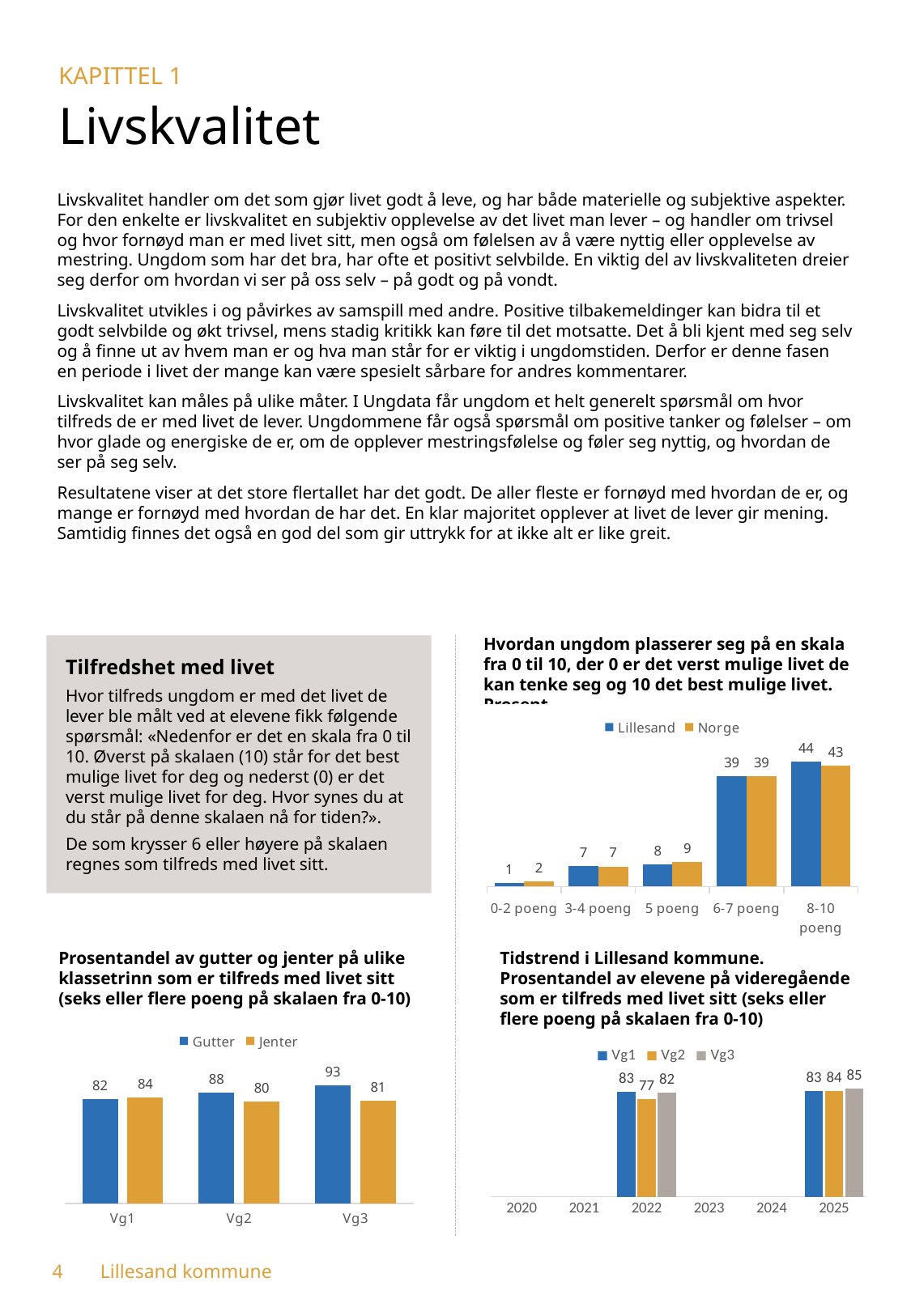
In the top-right chart (Hvordan ungdom plasserer seg på en skala fra 0 til 10), what is the value for Lillesand in the 8-10 poeng category? 44 In the top-right chart (Hvordan ungdom plasserer seg på en skala fra 0 til 10), which category has the lowest value for Lillesand? 0-2 poeng In the bottom-left chart (Prosentandel av gutter og jenter på ulike klassetrinn), do the Gutter values rise or fall from Vg1 to Vg3? rise In the bottom-right chart (Tidstrend i Lillesand kommune), what is the value for Vg2 in 2022? 77 In the top-right chart (Hvordan ungdom plasserer seg på en skala fra 0 til 10), how many categories are shown on the x axis? 5 In the top-right chart (Hvordan ungdom plasserer seg på en skala fra 0 til 10), which category has the highest value for Norge? 8-10 poeng In the bottom-left chart (Prosentandel av gutter og jenter på ulike klassetrinn), which is larger at Vg1, Gutter or Jenter? Jenter What kind of chart is the bottom-right chart (Tidstrend i Lillesand kommune)? bar chart In the bottom-right chart (Tidstrend i Lillesand kommune), which series has the highest value in 2025? Vg3 In the bottom-left chart (Prosentandel av gutter og jenter på ulike klassetrinn), what is the difference between Gutter and Jenter at Vg3? 12 In the top-right chart (Hvordan ungdom plasserer seg på en skala fra 0 til 10), how many series does the legend list? 2 In the bottom-left chart (Prosentandel av gutter og jenter på ulike klassetrinn), what is the value for Jenter at Vg2? 80